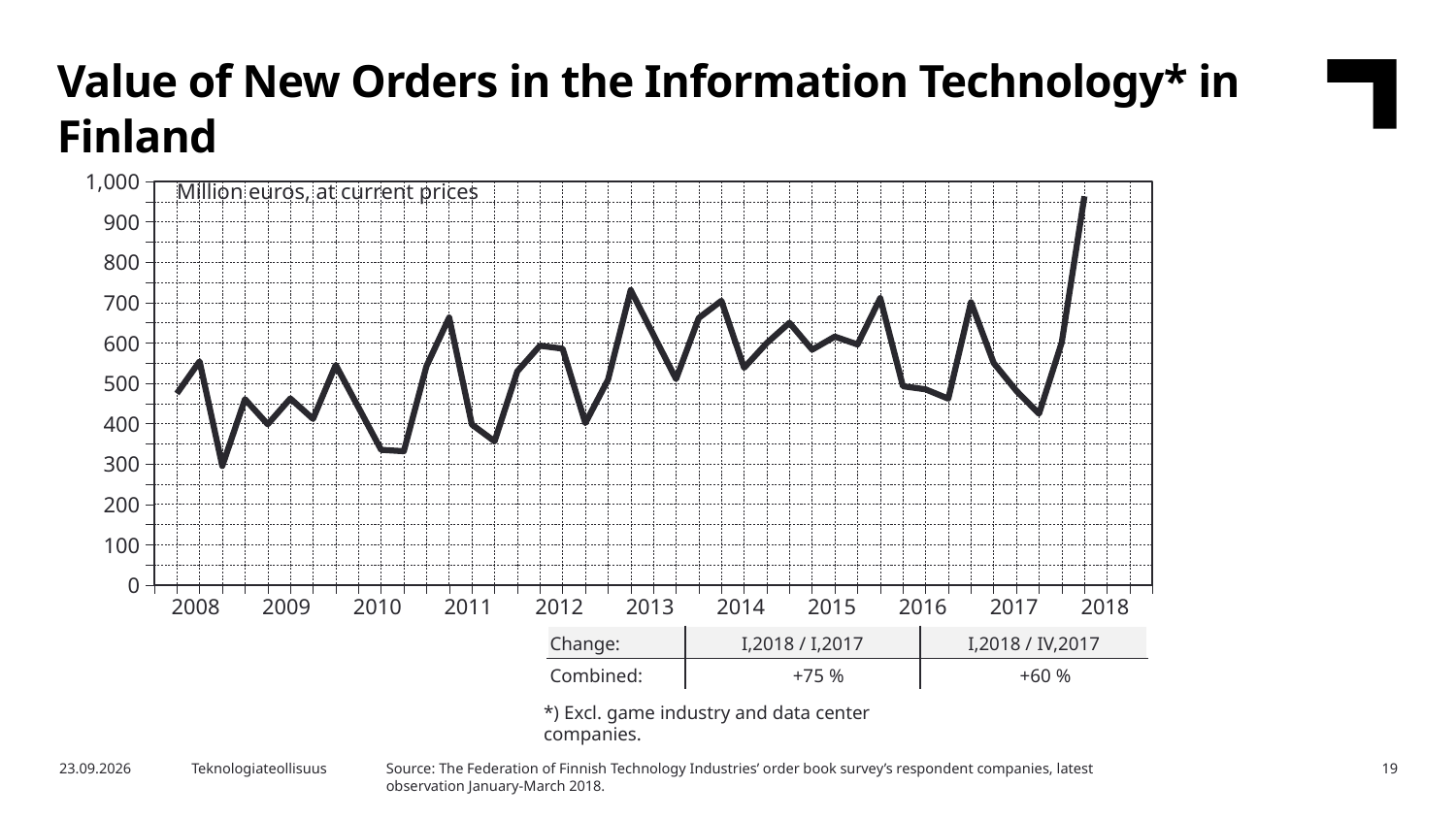
What type of chart is shown on the slide? Line chart In which year does the line reach its highest point? 2018 In which year does the line reach its lowest point? 2008 Is the peak value in 2013 greater or less than 600? greater How many year labels are shown on the x axis? 11 In what unit are the values on the chart expressed, according to the label inside the plot area? Million euros, at current prices What is the combined change for I,2018 / I,2017 shown in the table below the chart? +75 % What is the title of the chart? Value of New Orders in the Information Technology* in Finland Is the lowest value in 2008 greater or less than 400? less Does the line rise or fall between the end of 2017 and the start of 2018? rise What is the combined change for I,2018 / IV,2017 shown in the table below the chart? +60 % Is the value at the start of 2018 greater or less than 900? greater